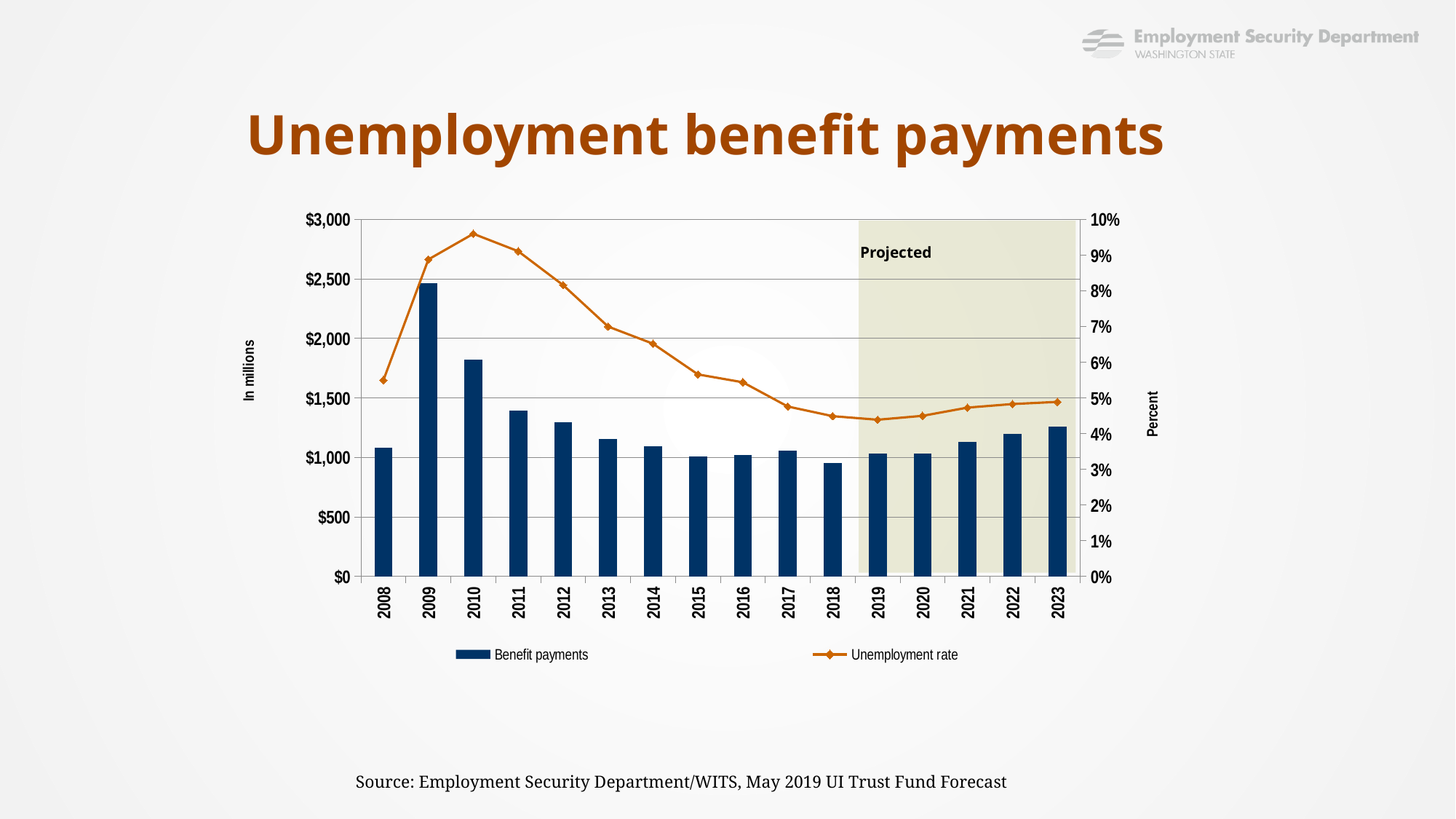
Which year has higher benefit payments, 2010 or 2011? 2010 Is the unemployment rate for 2014 greater or less than 7%? less Is the unemployment rate for 2019 greater or less than 5%? less Does the unemployment rate rise or fall from 2010 to 2019? fall In which year are benefit payments highest? 2009 Are benefit payments for 2009 greater or less than $2,000 million? greater How many years are shown on the x axis? 16 In which year are benefit payments lowest? 2018 How many series does the legend list? 2 In which year is the unemployment rate highest? 2010 What type of chart is shown on the slide? Combined bar and line chart